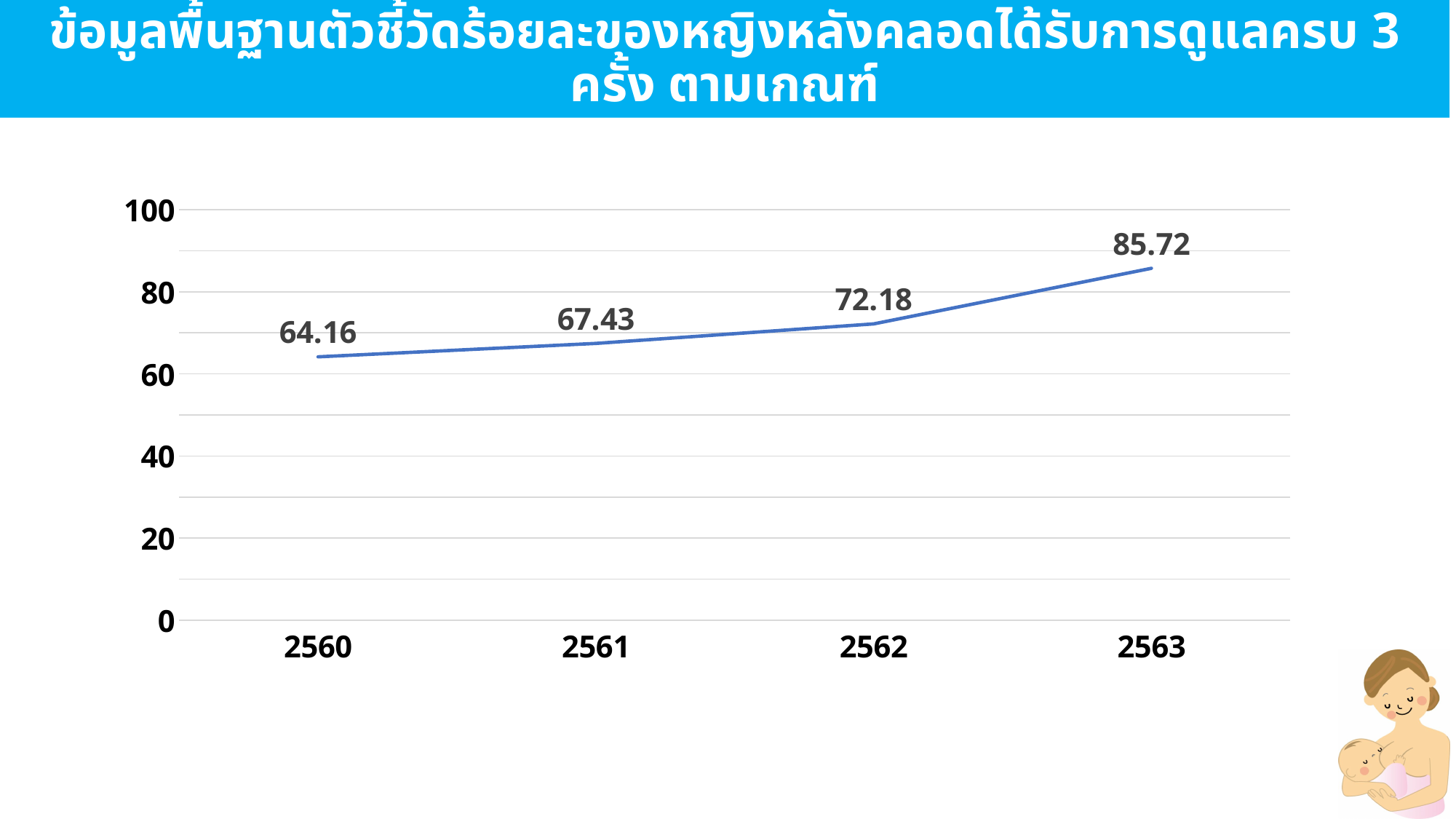
What is the difference between the values for 2561 and 2560? 3.27 What kind of chart is shown on the slide? line chart Which year has the highest value? 2563 How many years are plotted on the chart? 4 What is the difference between the values for 2563 and 2562? 13.54 Which year has the lowest value? 2560 What is the value for 2560? 64.16 Is the value for 2563 greater or less than 80? greater Which is larger, the value for 2562 or the value for 2561? 2562 What is the value for 2563? 85.72 What is the value for 2562? 72.18 What is the value for 2561? 67.43